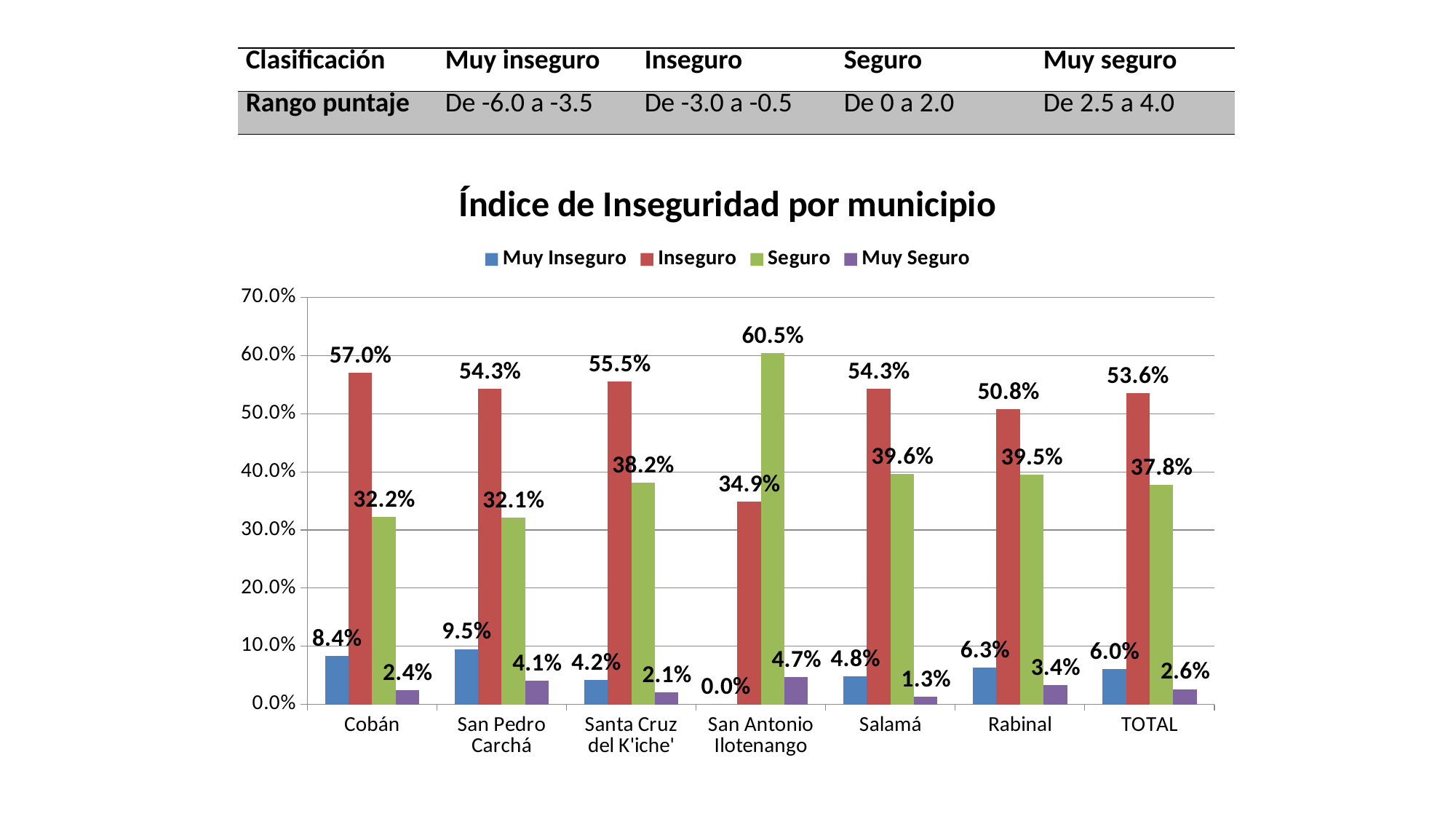
What is the Muy Seguro value for TOTAL? 2.6% What is the Seguro value for San Antonio Ilotenango? 60.5% Which municipality has the highest Seguro value? San Antonio Ilotenango Which is larger for Salamá: the Inseguro value or the Seguro value? Inseguro What is the Muy Inseguro value for San Pedro Carchá? 9.5% How many series does the legend list? 4 What kind of chart is shown? bar chart Is the Seguro value for Santa Cruz del K'iche' greater or less than 40.0%? less What is the Inseguro value for Cobán? 57.0% Which category has the lowest Muy Inseguro value? San Antonio Ilotenango What is the difference between the Inseguro and Seguro values for Rabinal? 11.3% How many categories are shown on the x axis? 7